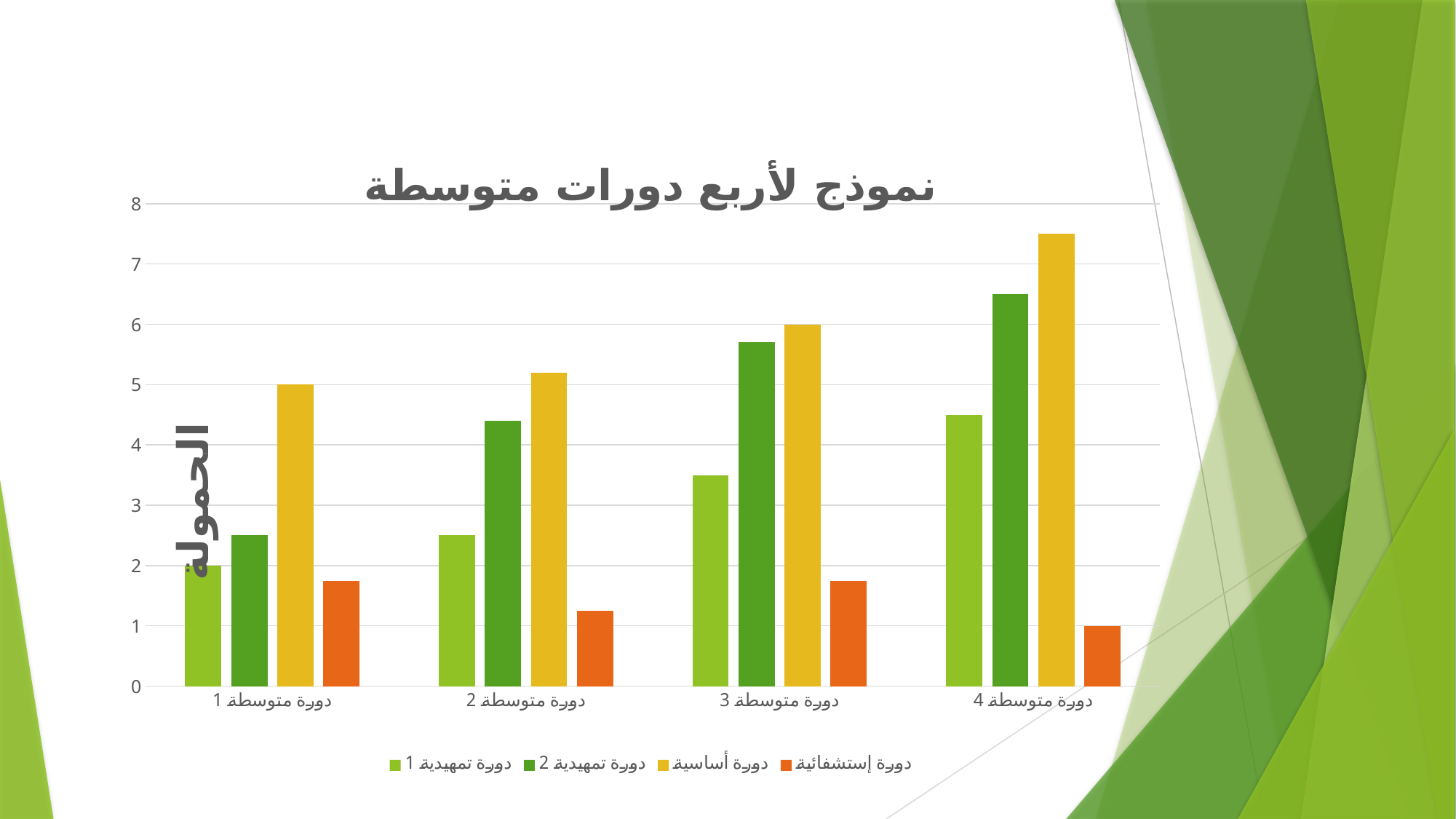
Is the value of دورة تمهيدية 2 for دورة متوسطة 2 greater or less than 4? greater Is the value of دورة أساسية for دورة متوسطة 4 greater or less than 7? greater How many categories are shown on the x axis? 4 What is the value of دورة تمهيدية 1 for دورة متوسطة 1? 2 What is the value of دورة إستشفائية for دورة متوسطة 4? 1 What is the title of the chart? نموذج لأربع دورات متوسطة What is the value of دورة أساسية for دورة متوسطة 1? 5 What is the value of دورة أساسية for دورة متوسطة 3? 6 Do the values of دورة أساسية rise or fall from دورة متوسطة 1 to دورة متوسطة 4? rise How many series does the legend list? 4 In which category is the دورة أساسية bar highest? دورة متوسطة 4 What type of chart is shown on the slide? bar chart